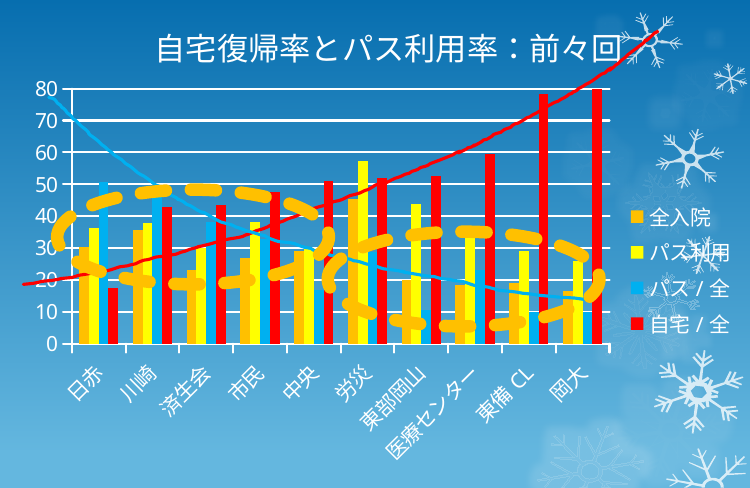
Do the values for パス / 全 rise or fall from left to right along the x axis? fall Which category has the lowest value for 自宅 / 全? 日赤 Which category has the highest value for 全入院? 労災 How many categories (hospitals) are shown on the x axis? 10 What is the title of the chart? 自宅復帰率とパス利用率：前々回 Which category has the highest value for パス / 全? 日赤 Do the values for 自宅 / 全 rise or fall from left to right along the x axis? rise For 岡大, which is larger: 自宅 / 全 or パス / 全? 自宅 / 全 What kind of chart is shown on the slide? bar chart How many series does the legend list? 4 Which category has the highest value for パス利用? 労災